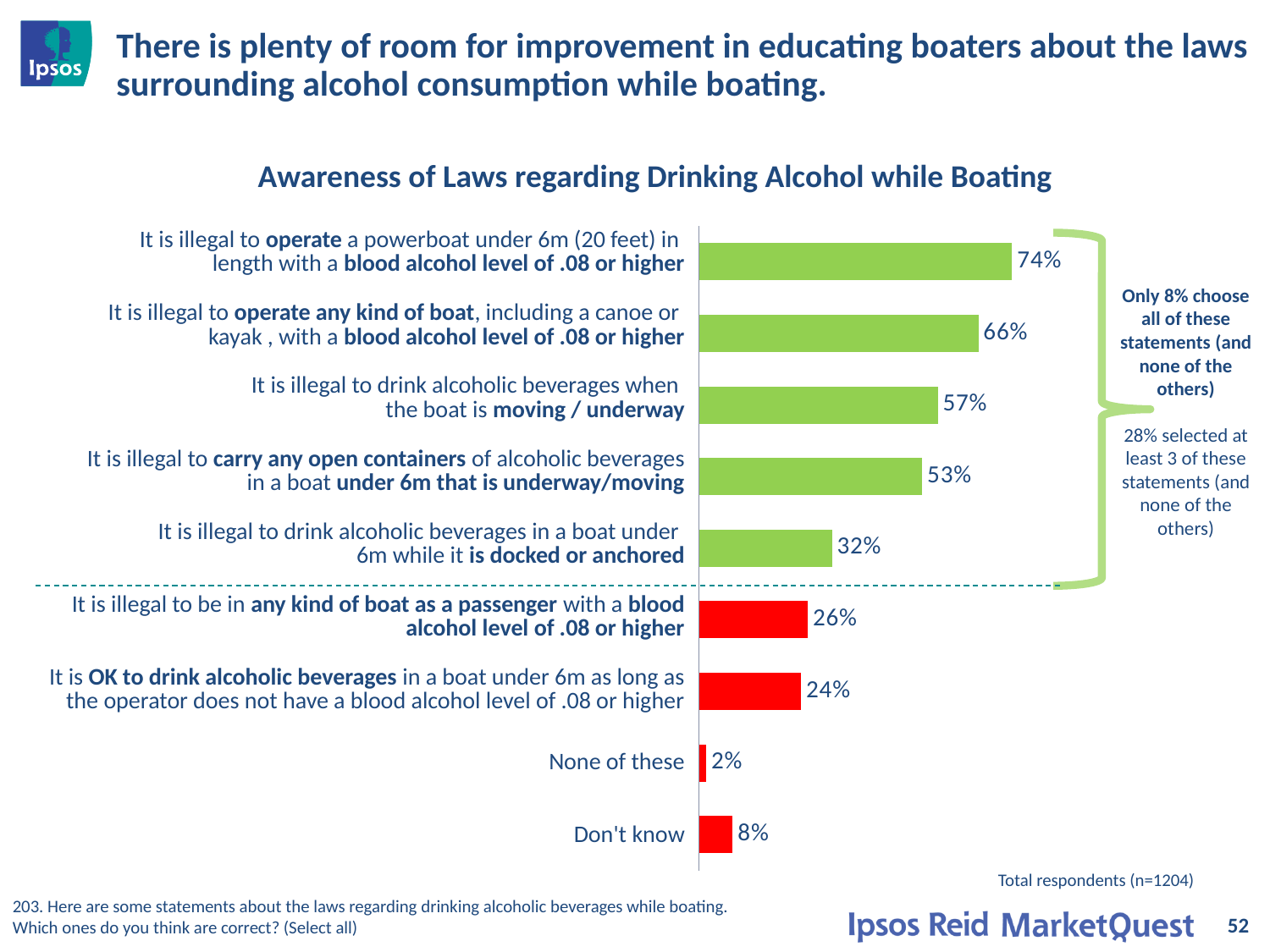
What percentage of respondents said it is illegal to operate a powerboat under 6m in length with a blood alcohol level of .08 or higher? 74% Which statement has the highest percentage in the chart? It is illegal to operate a powerboat under 6m (20 feet) in length with a blood alcohol level of .08 or higher Which category has the lowest percentage in the chart? None of these What is the title of the chart? Awareness of Laws regarding Drinking Alcohol while Boating How many categories (bars) are shown in the chart? 9 According to the callout on the chart, what percentage of respondents chose all of the green statements and none of the others? 8% What percentage of respondents said it is illegal to drink alcoholic beverages when the boat is moving / underway? 57% What is the difference in percentage points between the 'operate any kind of boat' statement (66%) and the 'carry any open containers' statement (53%)? 13 Which has a higher percentage: the statement about being a passenger with a blood alcohol level of .08 or higher, or the statement that it is OK to drink alcoholic beverages as long as the operator does not have a blood alcohol level of .08 or higher? The passenger statement (26%) What percentage of respondents selected 'Don't know'? 8% What percentage of respondents said it is illegal to drink alcoholic beverages in a boat under 6m while it is docked or anchored? 32% What type of chart is shown on the slide? Bar chart